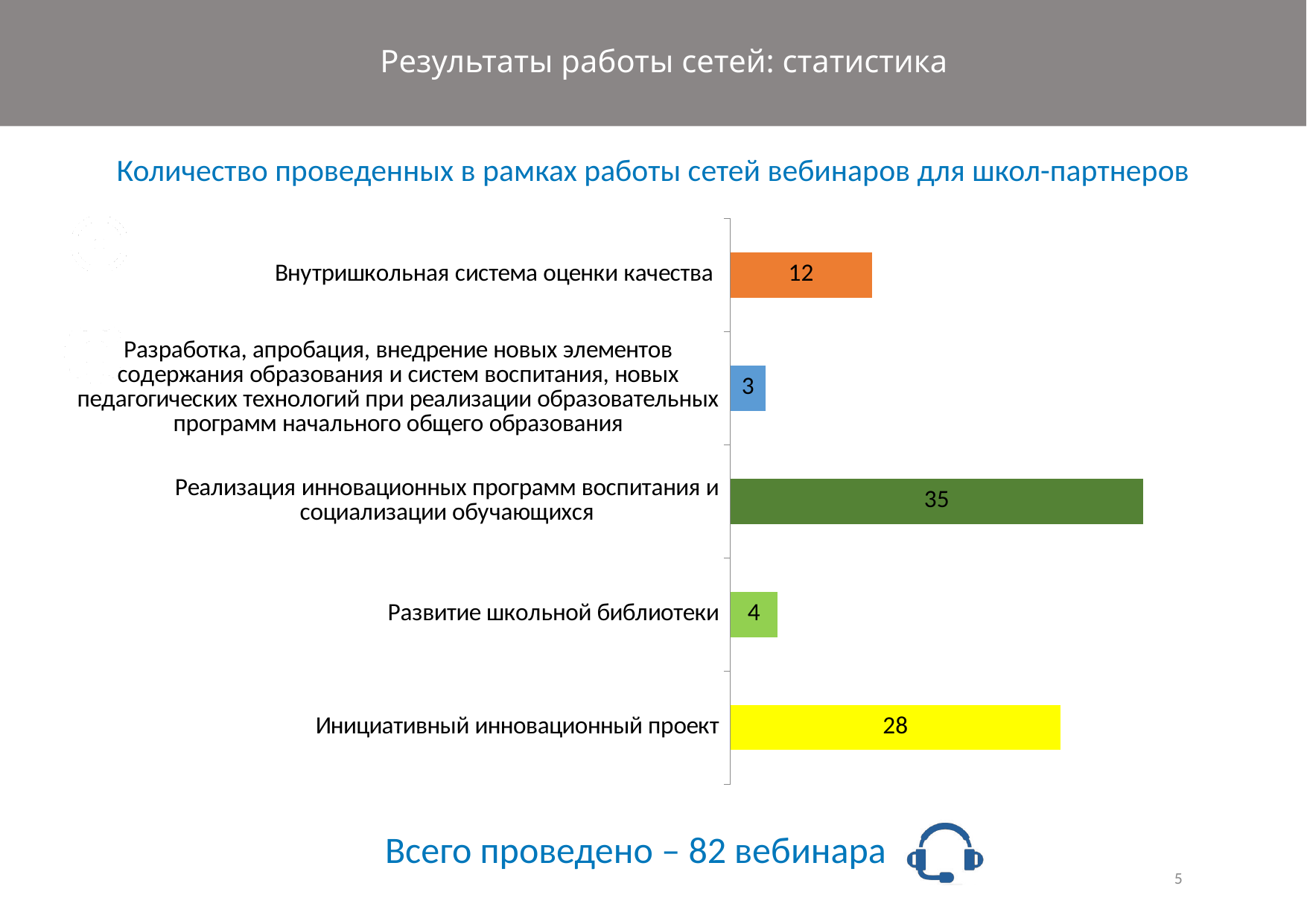
What colour is the bar for "Инициативный инновационный проект"? Yellow Which is larger: the value for "Внутришкольная система оценки качества" or for "Развитие школьной библиотеки"? Внутришкольная система оценки качества What is the value for "Развитие школьной библиотеки"? 4 How many categories are shown in the chart? 5 What is the title of the chart? Количество проведенных в рамках работы сетей вебинаров для школ-партнеров What is the value for "Инициативный инновационный проект"? 28 What is the value for "Реализация инновационных программ воспитания и социализации обучающихся"? 35 Which category has the highest number of webinars? Реализация инновационных программ воспитания и социализации обучающихся What is the difference between the values for "Реализация инновационных программ воспитания и социализации обучающихся" and "Инициативный инновационный проект"? 7 How many webinars were held for "Внутришкольная система оценки качества"? 12 What kind of chart is shown on the slide? Bar chart Which category has the lowest number of webinars? Разработка, апробация, внедрение новых элементов содержания образования и систем воспитания, новых педагогических технологий при реализации образовательных программ начального общего образования